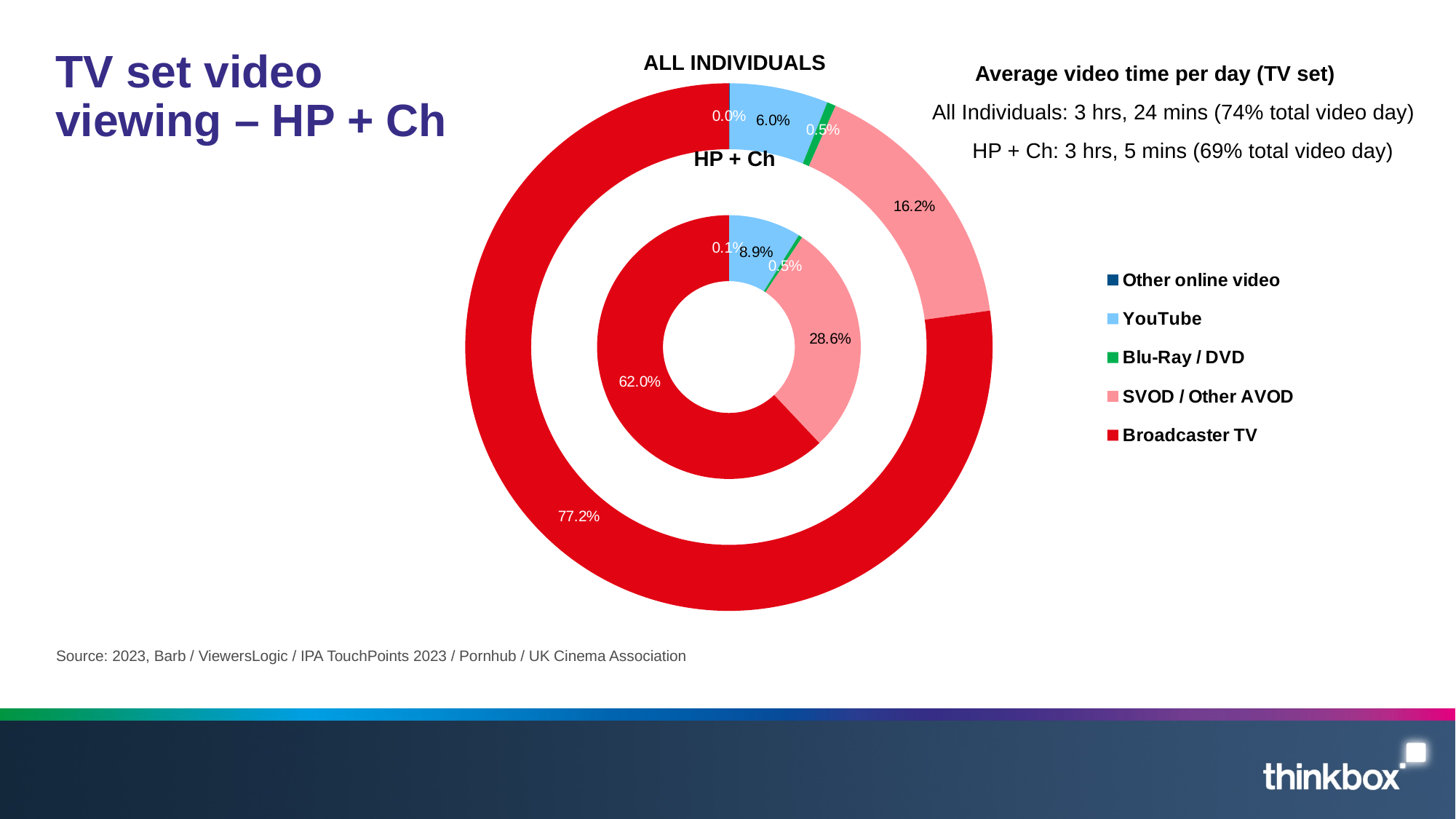
How many categories does the legend list? 5 How much larger is the SVOD / Other AVOD share for HP + Ch than for ALL INDIVIDUALS? 12.4 percentage points Which category has the smallest share in the ALL INDIVIDUALS ring? Other online video Which category has the largest share in the HP + Ch ring? Broadcaster TV What is the SVOD / Other AVOD share in the ALL INDIVIDUALS ring? 16.2% What is the YouTube share in the HP + Ch ring? 8.9% Which colour represents Broadcaster TV in the chart? Red What share of TV set video viewing does Broadcaster TV account for in the HP + Ch ring? 62.0% What kind of chart is shown on the slide? Doughnut chart What is the Blu-Ray / DVD share in the ALL INDIVIDUALS ring? 0.5% What share of TV set video viewing does Broadcaster TV account for in the ALL INDIVIDUALS ring? 77.2% Which ring has the larger YouTube share, ALL INDIVIDUALS or HP + Ch? HP + Ch